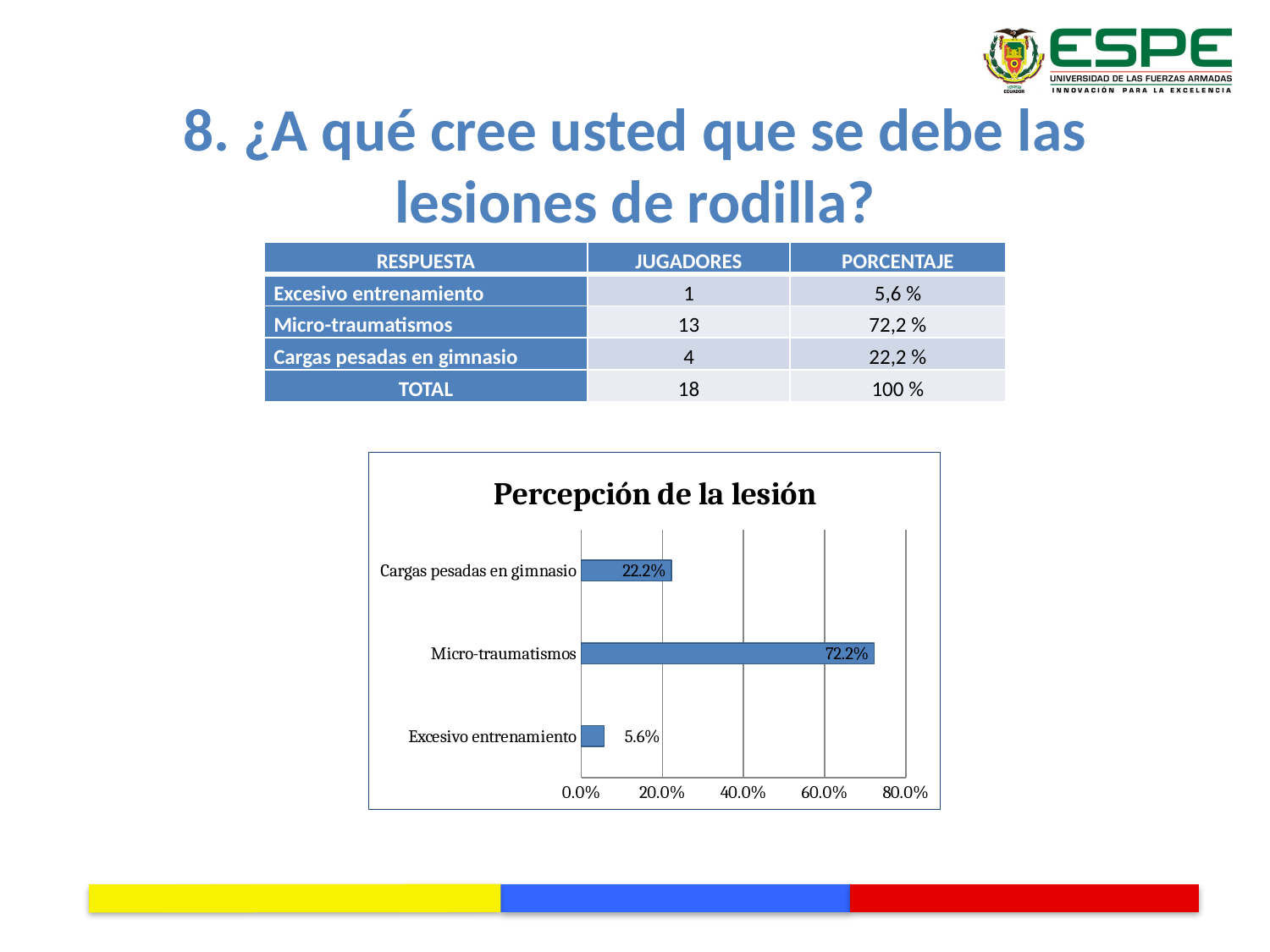
Which category has the lowest value in the chart? Excesivo entrenamiento What is the value for Excesivo entrenamiento in the chart? 5.6% What is the difference between the values for Micro-traumatismos and Cargas pesadas en gimnasio? 50.0% Which is larger, the value for Cargas pesadas en gimnasio or the value for Excesivo entrenamiento? Cargas pesadas en gimnasio Which category has the highest value in the chart? Micro-traumatismos What is the value for Micro-traumatismos in the chart? 72.2% What is the title of the chart? Percepción de la lesión What is the value for Cargas pesadas en gimnasio in the chart? 22.2% What kind of chart is shown on the slide? bar chart Is the value for Micro-traumatismos greater or less than 60.0%? greater How many categories are shown in the chart? 3 What is the difference between the values for Cargas pesadas en gimnasio and Excesivo entrenamiento? 16.6%